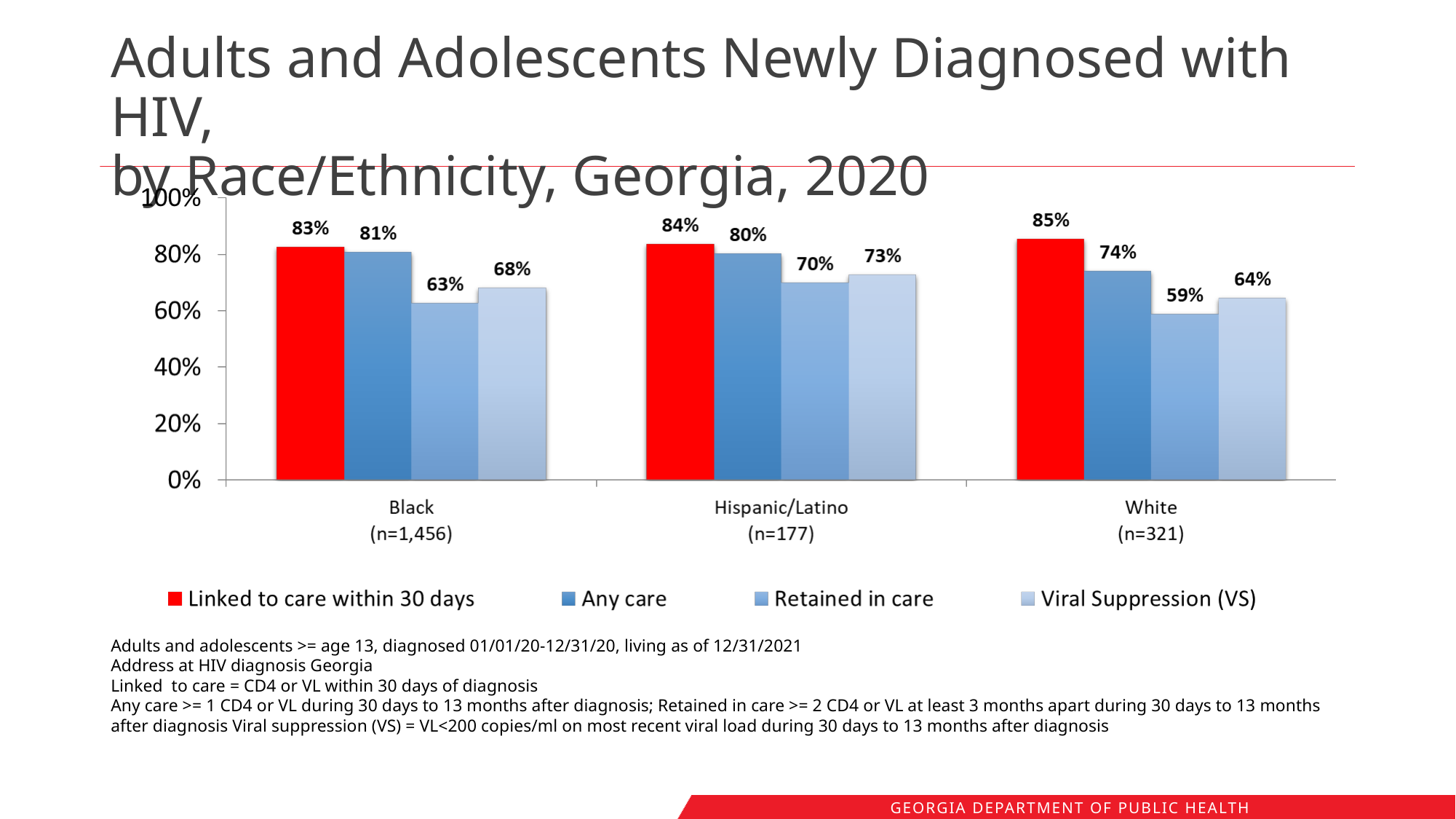
Which is larger: the Viral Suppression (VS) value for Black or for White? Black Is the Any care value for the White group greater or less than 80%? less What is the Viral Suppression (VS) value for the Hispanic/Latino group? 73% What is the Retained in care value for the White group? 59% Which race/ethnicity group has the highest value for Linked to care within 30 days? White What percentage of Black adults and adolescents were linked to care within 30 days? 83% What is the sample size (n) shown for the Hispanic/Latino group? n=177 Which race/ethnicity group has the lowest Retained in care value? White How many series does the legend list? 4 What kind of chart is shown on the slide? bar chart How many race/ethnicity categories are shown on the x axis? 3 What is the difference between the Any care value and the Retained in care value for the Black group? 18%